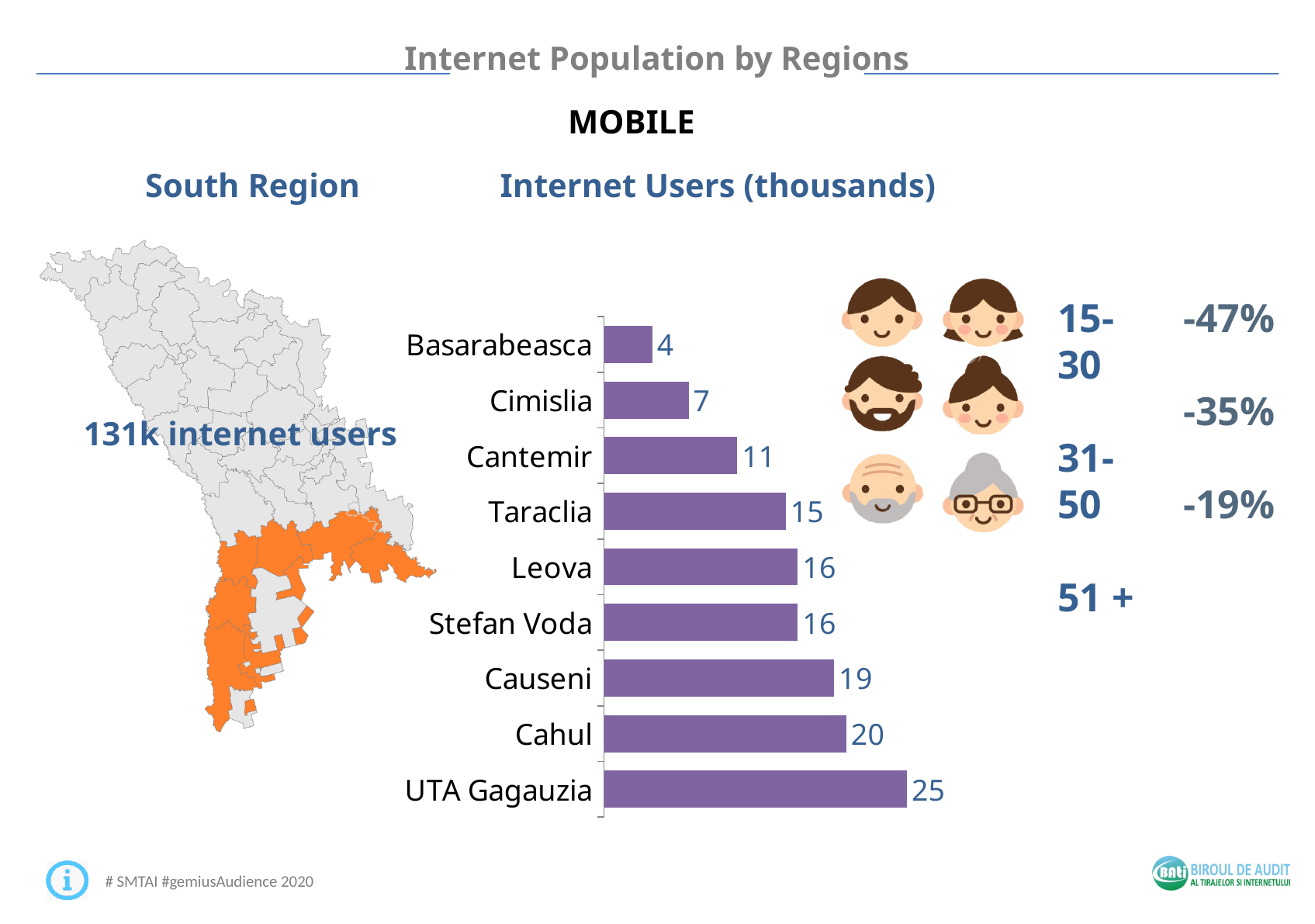
How many categories are shown in the Internet Users (thousands) chart? 9 Which category has the lowest value in the Internet Users (thousands) chart? Basarabeasca What colour are the bars in the Internet Users (thousands) chart? Purple What is the value for Causeni in the Internet Users (thousands) chart? 19 Which is larger in the Internet Users (thousands) chart, Taraclia or Causeni? Causeni What is the value for UTA Gagauzia in the Internet Users (thousands) chart? 25 What kind of chart is the Internet Users (thousands) chart? Bar chart Which category has the highest value in the Internet Users (thousands) chart? UTA Gagauzia What is the value for Cantemir in the Internet Users (thousands) chart? 11 What is the value for Leova in the Internet Users (thousands) chart? 16 What is the difference between the values for UTA Gagauzia and Basarabeasca in the Internet Users (thousands) chart? 21 What is the difference between the values for Cahul and Cimislia in the Internet Users (thousands) chart? 13